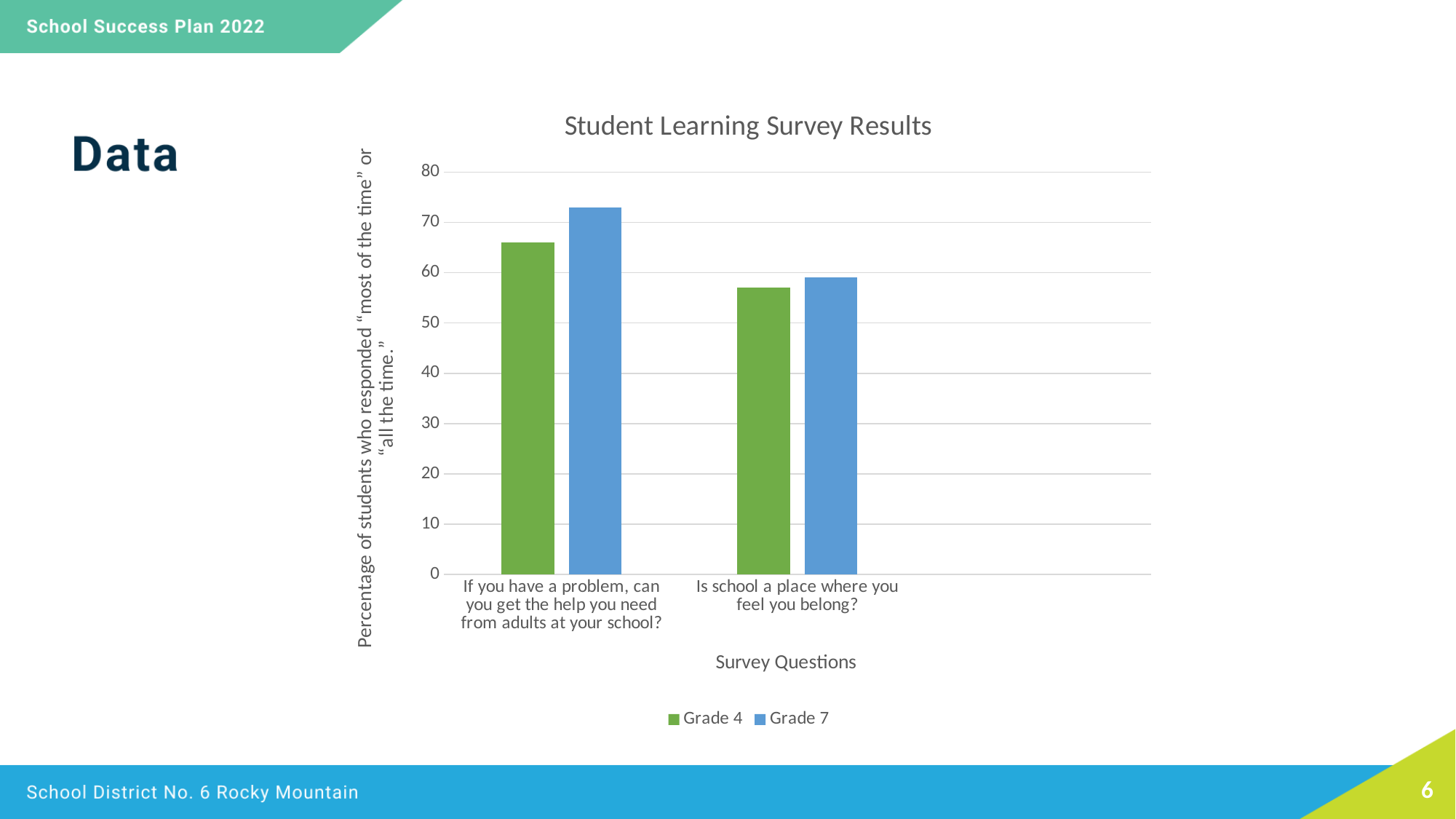
How many series does the legend list? 2 Do the Grade 4 values rise or fall from the first survey question to the second? fall What is the title of the chart? Student Learning Survey Results Is the Grade 7 value for "If you have a problem, can you get the help you need from adults at your school?" greater or less than 70? greater What type of chart is shown on the slide? bar chart Is the Grade 4 value for "If you have a problem, can you get the help you need from adults at your school?" greater or less than 60? greater For the question "If you have a problem, can you get the help you need from adults at your school?", which grade has the higher value? Grade 7 Which series is shown in green? Grade 4 Which bar is the highest in the chart? Grade 7, "If you have a problem, can you get the help you need from adults at your school?" Is the Grade 7 value for "Is school a place where you feel you belong?" greater or less than 50? greater How many survey questions are shown on the x axis? 2